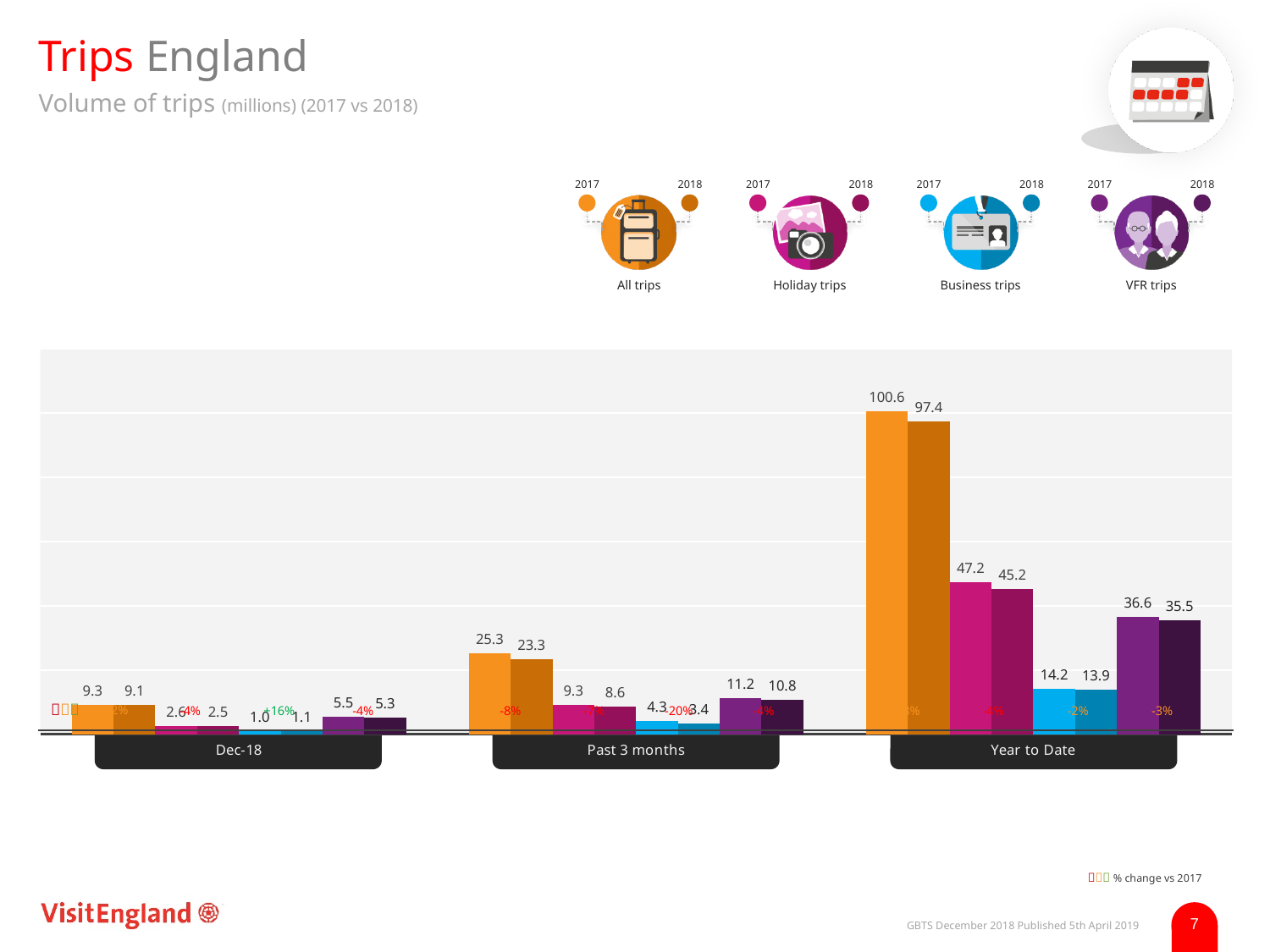
What is the percentage change shown for Business trips in Dec-18? +16% What is the value for Business trips in 2018 for Year to Date? 13.9 What is the value for VFR trips in 2017 for Dec-18? 5.5 Which trip type has the lowest 2018 value in the Dec-18 group? Business trips Which category group has the highest value for All trips in 2017? Year to Date Which is larger for Past 3 months: VFR trips in 2017 or Holiday trips in 2017? VFR trips in 2017 What is the value for Holiday trips in 2018 for Past 3 months? 8.6 What is the difference between the 2017 and 2018 values for All trips in Year to Date? 3.2 What type of chart is shown on the slide? Bar chart What is the value for All trips in 2018 for Year to Date? 97.4 How many category groups are shown on the x axis? 3 What is the value for All trips in 2017 for Year to Date? 100.6